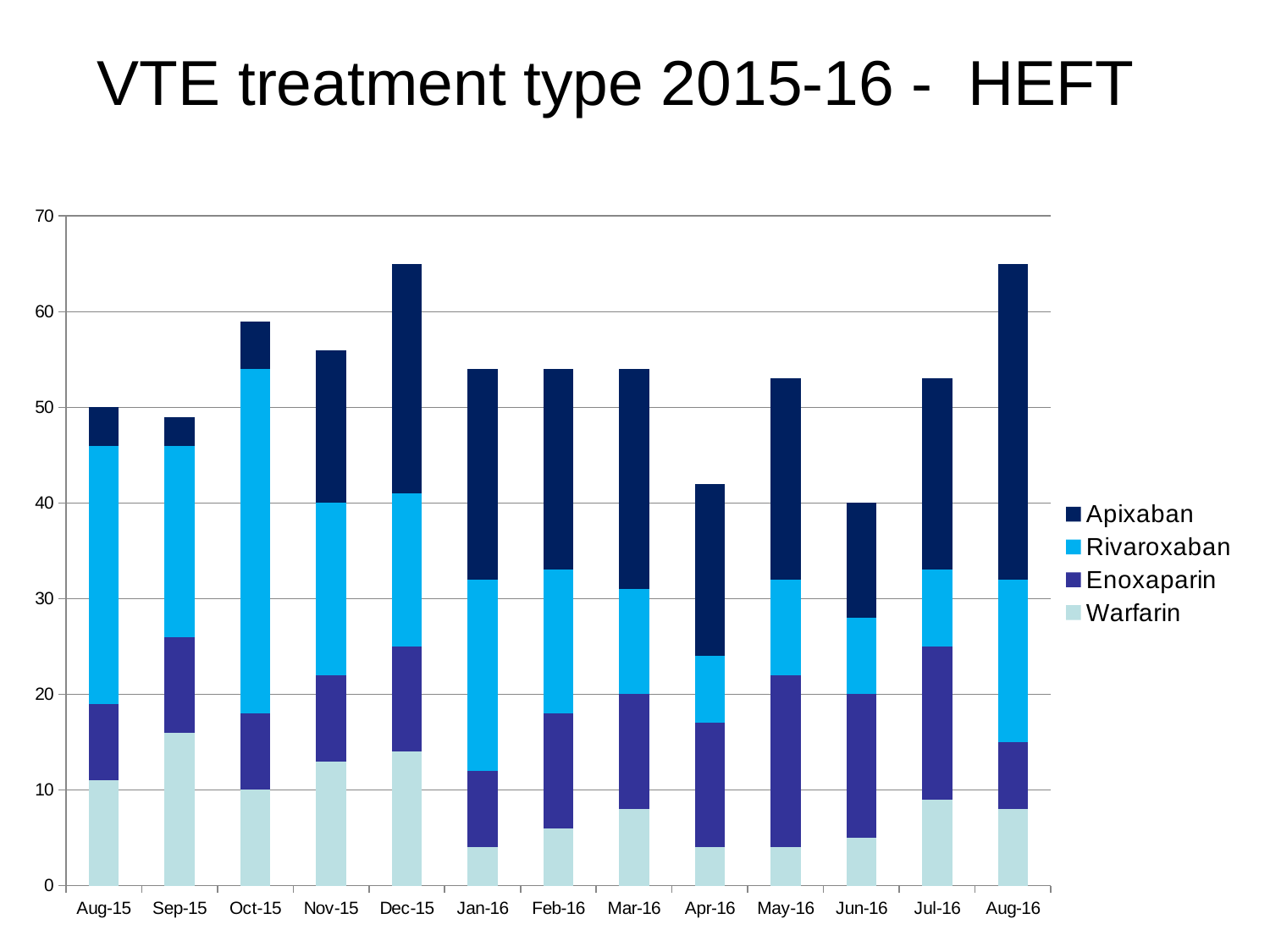
What is the title of the chart? VTE treatment type 2015-16 - HEFT Which has the larger Apixaban segment, Aug-16 or Aug-15? Aug-16 Is the Warfarin value for Sep-15 greater or less than 10? greater Is the Warfarin value for Jan-16 greater or less than 10? less How many series does the legend list? 4 How many months are shown along the x axis? 13 Which treatment types are listed in the legend? Apixaban, Rivaroxaban, Enoxaparin, Warfarin Is the total height of the Dec-15 bar greater or less than 60? greater What kind of chart is shown on the slide? stacked bar chart Which bar is taller in total, Oct-15 or Sep-15? Oct-15 What is the total height of the Jun-16 bar? 40